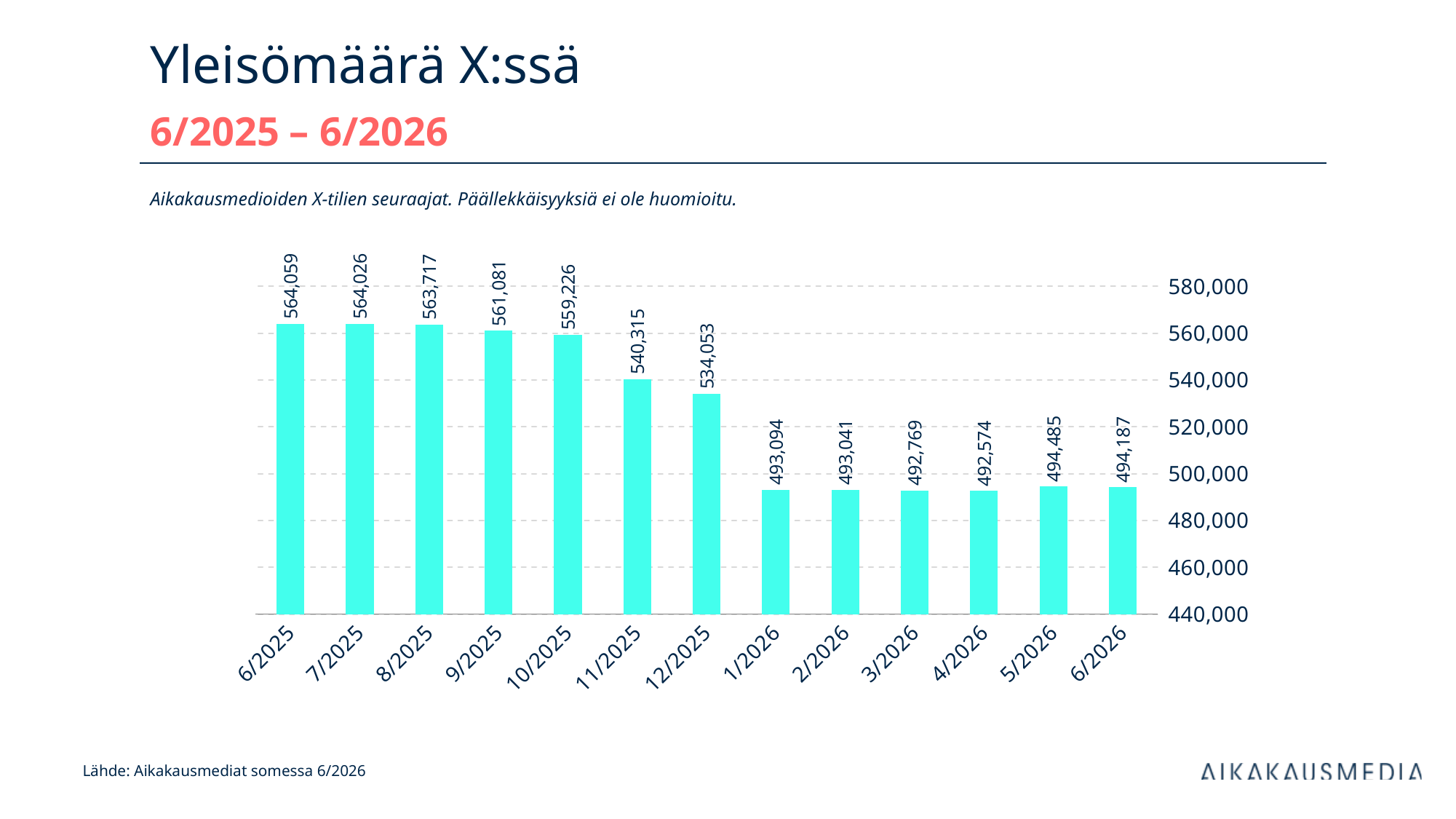
Which month has the highest value? 6/2025 How many months are shown on the x axis? 13 What is the value for 6/2025? 564,059 Which month has the lowest value? 4/2026 What kind of chart is shown on the slide? bar chart Which is larger, the value for 10/2025 or the value for 1/2026? 10/2025 What is the difference between the values for 11/2025 and 12/2025? 6,262 Do the values generally rise or fall from 6/2025 to 6/2026? fall What is the value for 6/2026? 494,187 What is the difference between the values for 6/2025 and 6/2026? 69,872 Is the value for 11/2025 greater or less than 560,000? less What is the value for 12/2025? 534,053